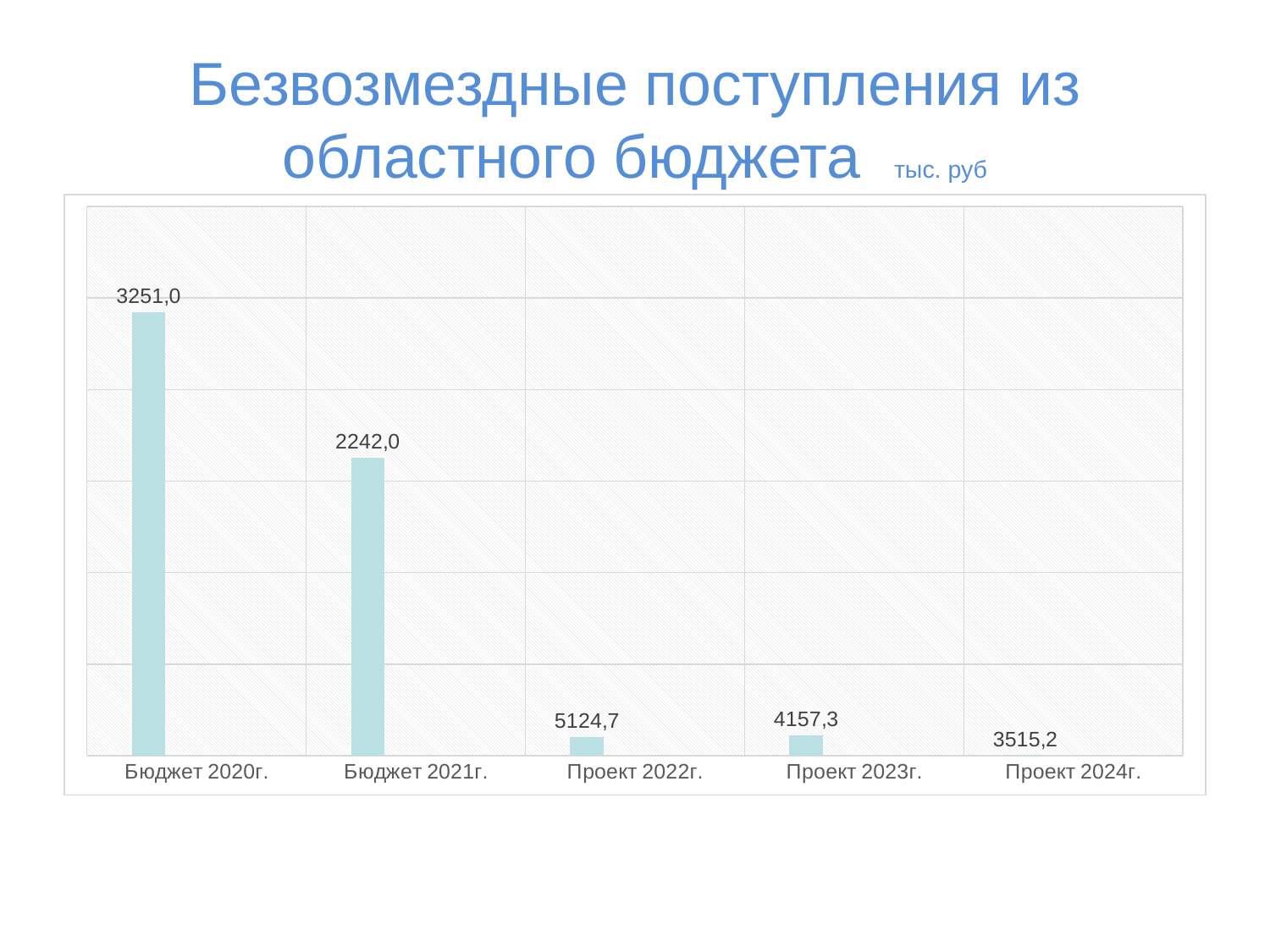
What is the difference between the values for Проект 2022г. and Проект 2023г.? 967,4 What is the value for Бюджет 2021г.? 2242,0 What is the difference between the values for Бюджет 2020г. and Бюджет 2021г.? 1009,0 What kind of chart is shown on the slide? Bar chart Which is larger, the value for Бюджет 2020г. or Бюджет 2021г.? Бюджет 2020г. What is the value for Проект 2024г.? 3515,2 What is the value for Бюджет 2020г.? 3251,0 What is the title of the chart? Безвозмездные поступления из областного бюджета What is the value for Проект 2022г.? 5124,7 How many categories are shown on the x axis? 5 In what units are the values given, according to the slide? тыс. руб What is the value for Проект 2023г.? 4157,3